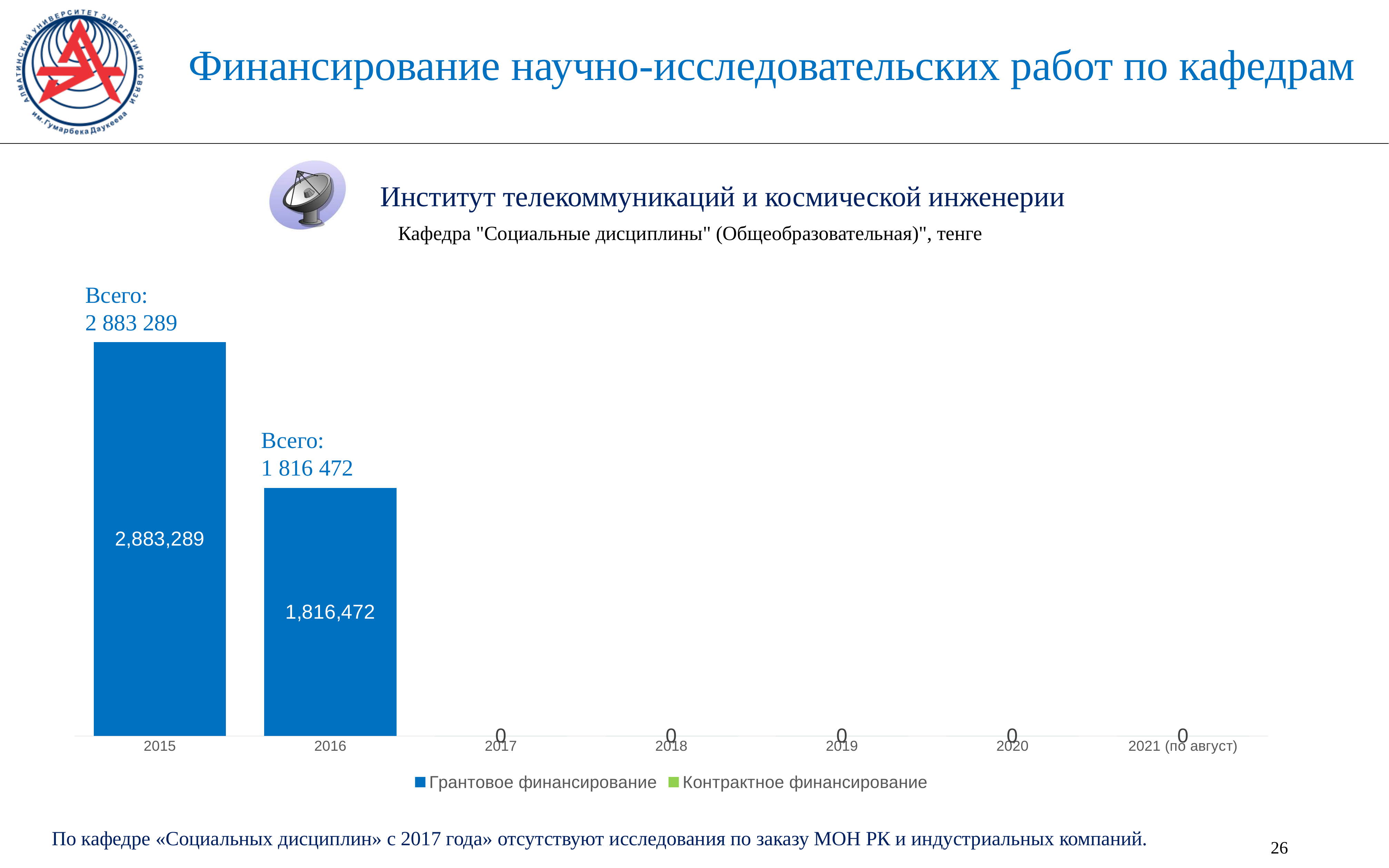
Which is larger, the value for 2015 or the value for 2016? 2015 Do the values rise or fall from 2015 to 2016? fall How many series does the legend list? 2 How many year categories are shown on the x axis? 7 What is the total (Всего) shown above the 2016 bar? 1 816 472 What type of chart is shown on the slide? bar chart What is the grant funding value for 2015? 2,883,289 What is the difference between the 2015 and 2016 values? 1,066,817 What is the grant funding value for 2016? 1,816,472 What is the label of the last category on the x axis? 2021 (по август) Which year has the highest funding value? 2015 What is the value shown for 2018? 0